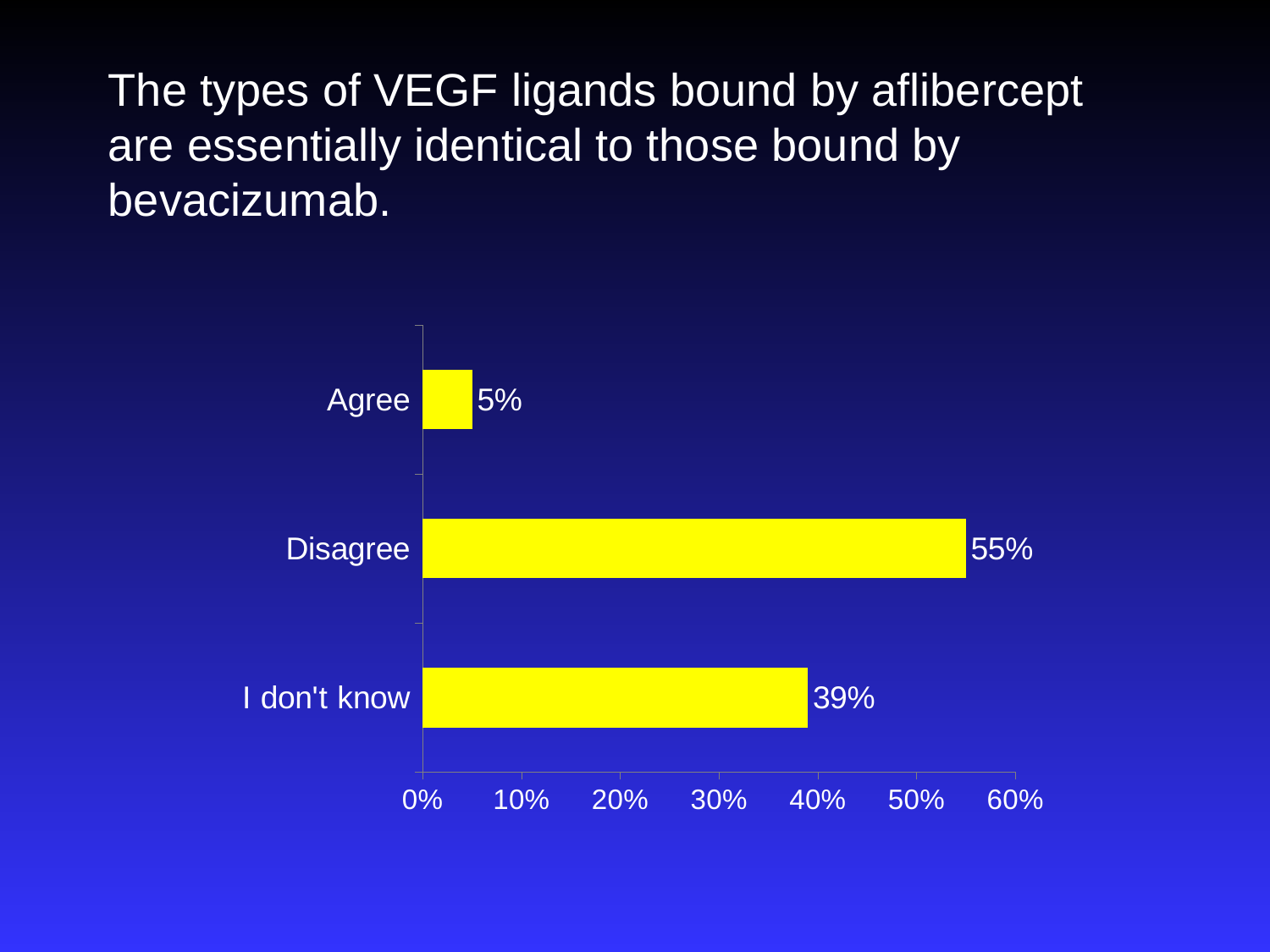
What percentage of respondents chose "I don't know"? 39% What is the difference in percentage points between "Disagree" and "Agree"? 50 What percentage of respondents chose "Agree"? 5% What is the difference in percentage points between "Disagree" and "I don't know"? 16 How many response categories are shown in the chart? 3 Is the value for "Disagree" greater or less than 50%? greater What kind of chart is shown on the slide? Bar chart Which response category has the lowest percentage? Agree Which response category has the highest percentage? Disagree What is the maximum value shown on the horizontal axis? 60% Which is larger, the value for "I don't know" or the value for "Agree"? I don't know What percentage of respondents chose "Disagree"? 55%